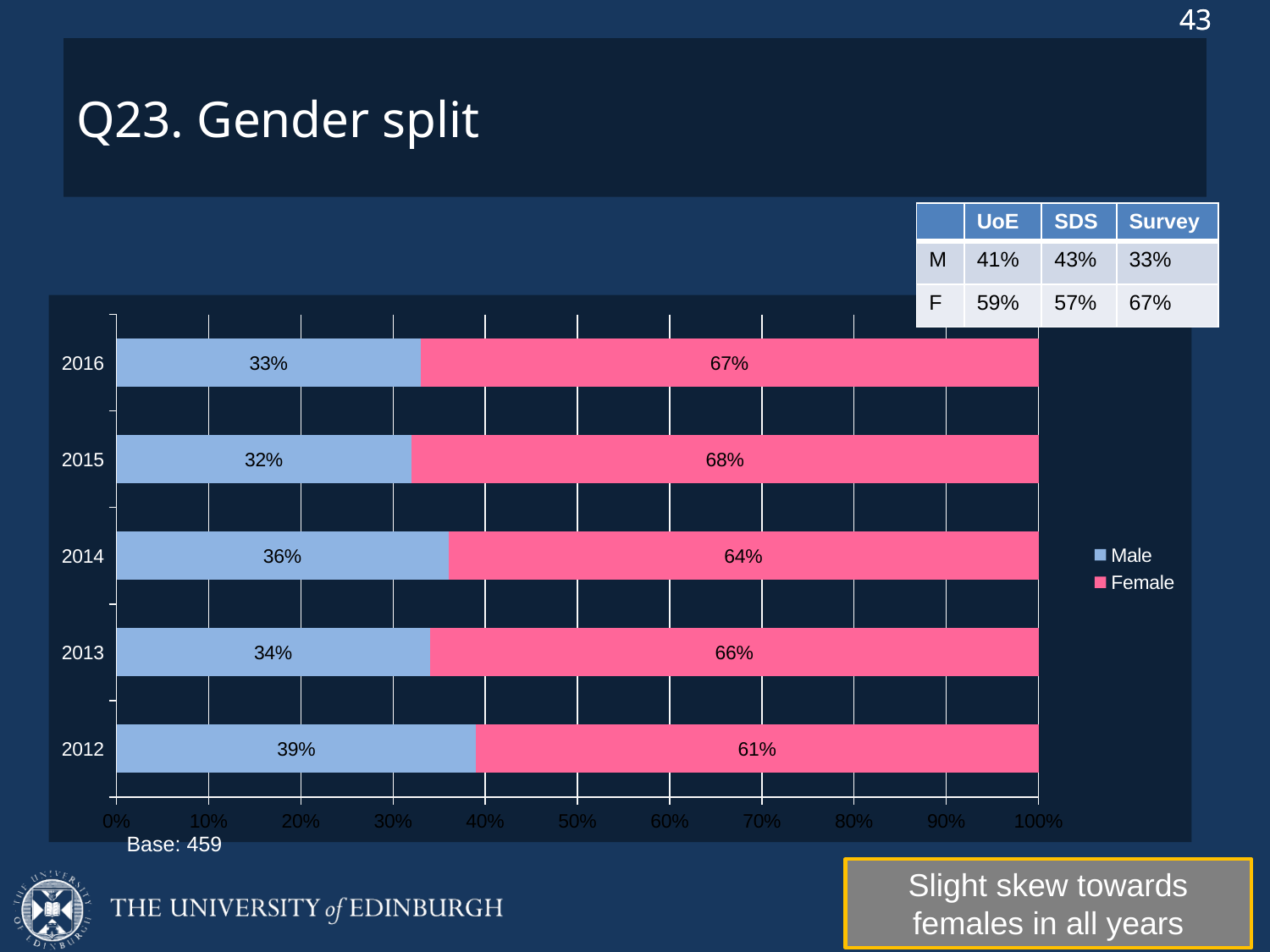
How many series does the legend list? 2 Which year has the highest Male percentage? 2012 What is the total of the stacked bar for 2015? 100% What is the difference between the Female and Male percentages in 2013? 32 percentage points What is the Female value for 2014? 64% How many years are shown on the chart? 5 Is the Male percentage larger in 2014 or in 2016? 2014 What kind of chart is shown on the slide? Stacked bar chart What percentage of respondents were male in 2016? 33% Which year has the highest Female percentage? 2015 Which year has the lowest Male percentage? 2015 What percentage of respondents were female in 2012? 61%